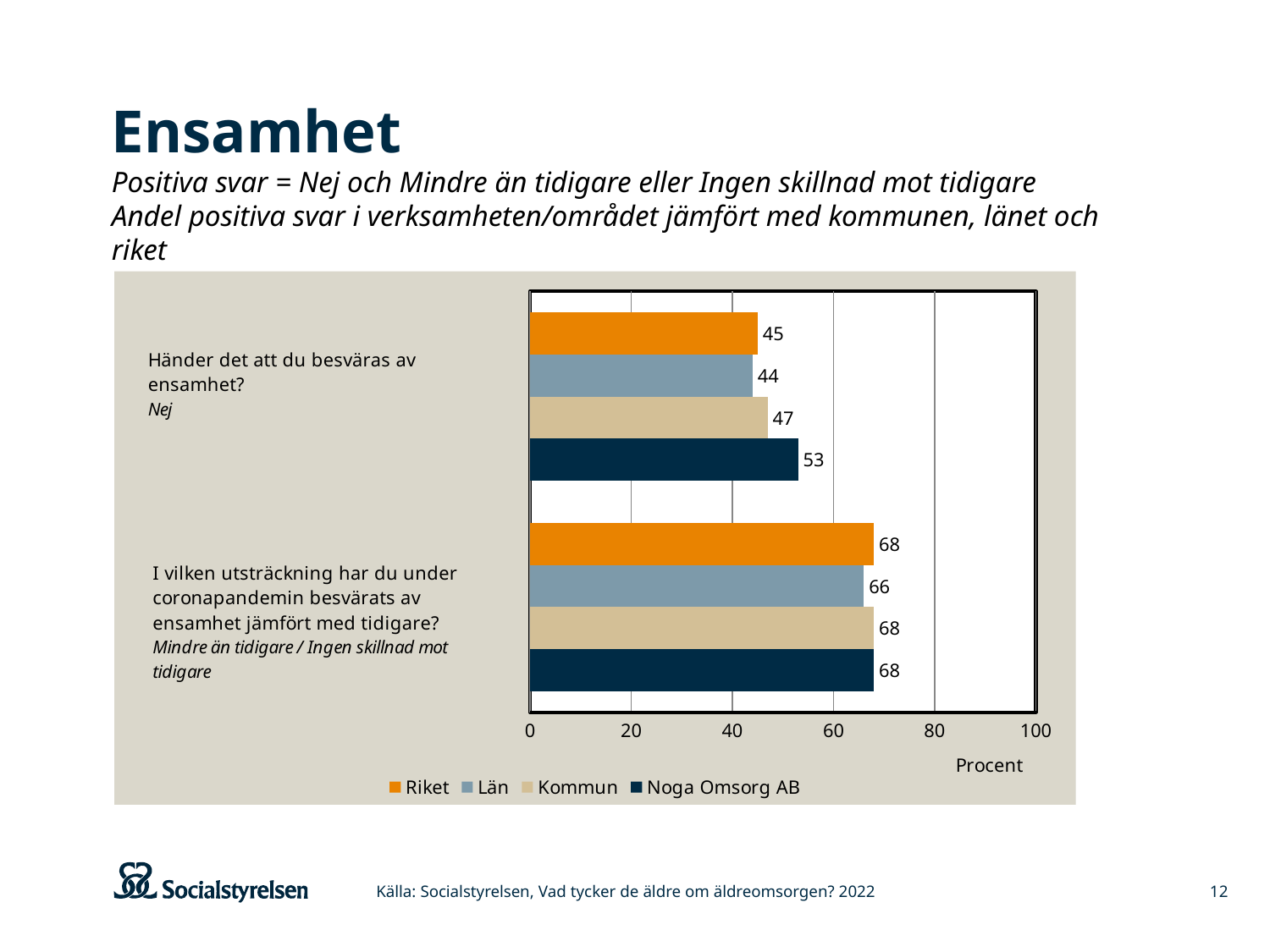
Is the value for Noga Omsorg AB on the question "Händer det att du besväras av ensamhet?" greater or less than 60? less What kind of chart is shown on the slide? Bar chart What is the value for Noga Omsorg AB on the question "Händer det att du besväras av ensamhet?"? 53 What is the value for Län on the question "Händer det att du besväras av ensamhet?"? 44 What is the label on the horizontal axis of the chart? Procent What is the value for Län on the question "I vilken utsträckning har du under coronapandemin besvärats av ensamhet jämfört med tidigare?"? 66 What is the difference between the Noga Omsorg AB value and the Riket value on the question "Händer det att du besväras av ensamhet?"? 8 What is the value for Riket on the question "I vilken utsträckning har du under coronapandemin besvärats av ensamhet jämfört med tidigare?"? 68 Which is larger on the question "Händer det att du besväras av ensamhet?": the value for Kommun or the value for Riket? Kommun How many series does the legend list? 4 Which series has the lowest value on the question "Händer det att du besväras av ensamhet?"? Län Which series has the highest value on the question "Händer det att du besväras av ensamhet?"? Noga Omsorg AB